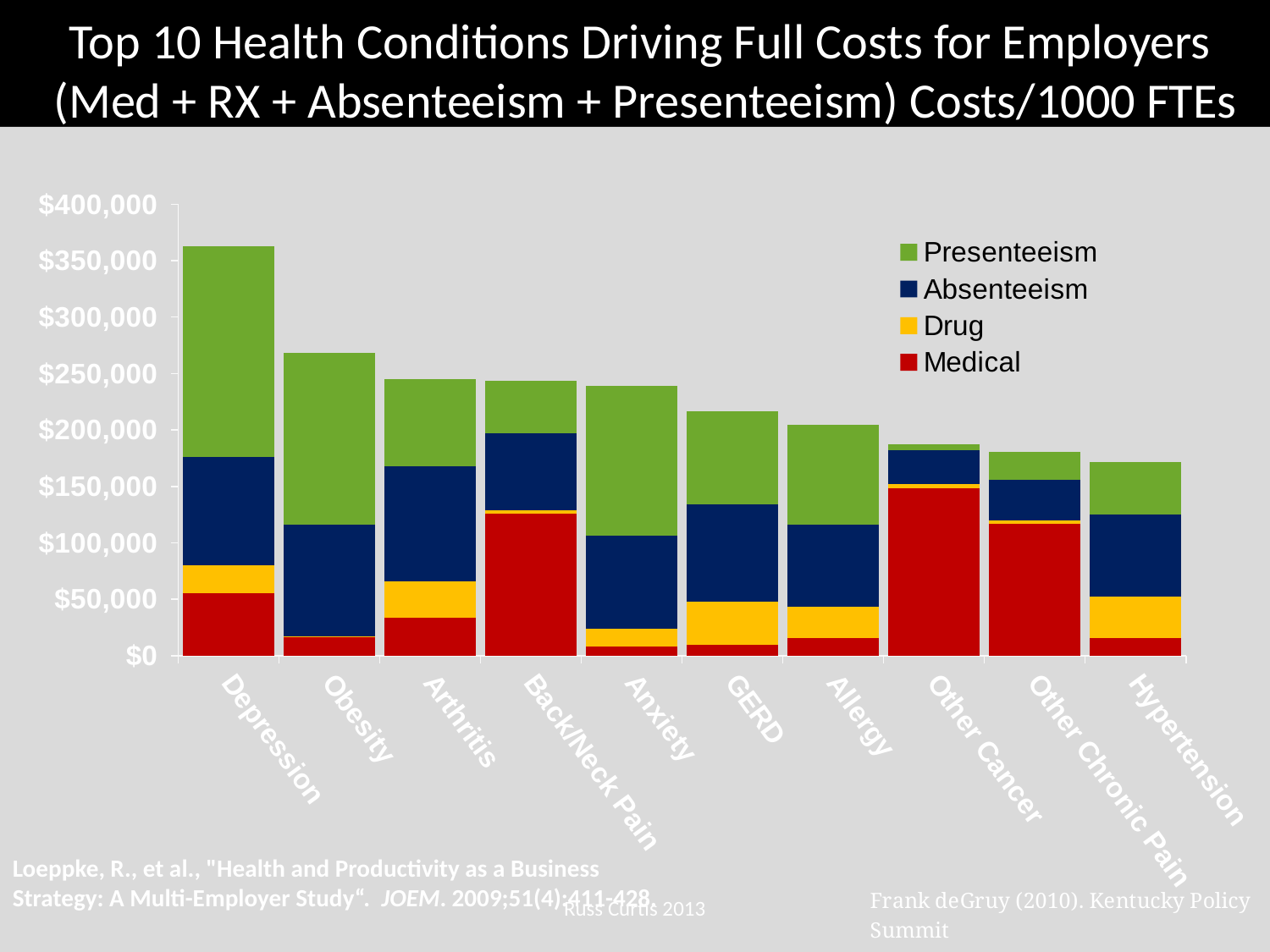
Is the Medical cost for Back/Neck Pain greater or less than $100,000? greater Which health condition has the highest total cost per 1000 FTEs? Depression Which has the larger total cost, Depression or Obesity? Depression How many series does the legend list? 4 Do the total costs generally rise or fall moving from left to right across the conditions? fall What kind of chart is shown on the slide? Stacked bar chart Which has the larger Medical cost, Back/Neck Pain or Depression? Back/Neck Pain Is the total cost for Depression greater or less than $350,000? greater How many health conditions are plotted along the x axis? 10 Is the total cost for Hypertension greater or less than $200,000? less Which series is shown in green in the legend? Presenteeism